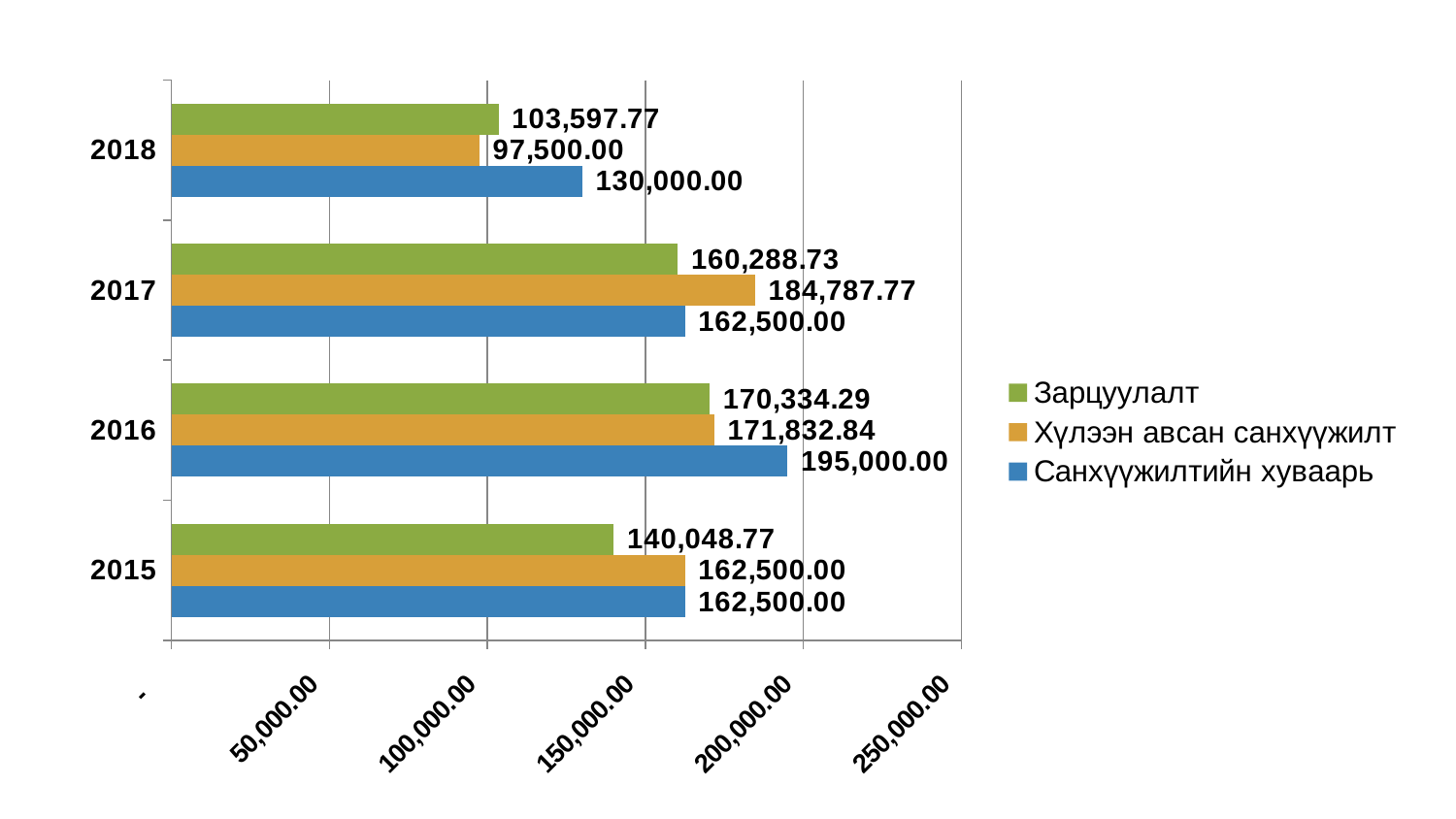
What is the value of Санхүүжилтийн хуваарь for 2016? 195,000.00 Is the value of Зарцуулалт for 2018 greater or less than 100,000.00? greater What is the value of Хүлээн авсан санхүүжилт for 2017? 184,787.77 What is the value of Зарцуулалт for 2018? 103,597.77 Which is larger in 2015: Зарцуулалт or Хүлээн авсан санхүүжилт? Хүлээн авсан санхүүжилт Which colour represents Санхүүжилтийн хуваарь in the legend? blue What is the difference between Санхүүжилтийн хуваарь and Хүлээн авсан санхүүжилт in 2018? 32,500.00 How many years are shown on the vertical axis? 4 In which year is Зарцуулалт the lowest? 2018 In which year is Санхүүжилтийн хуваарь the highest? 2016 How many series does the legend list? 3 What type of chart is shown on the slide? bar chart